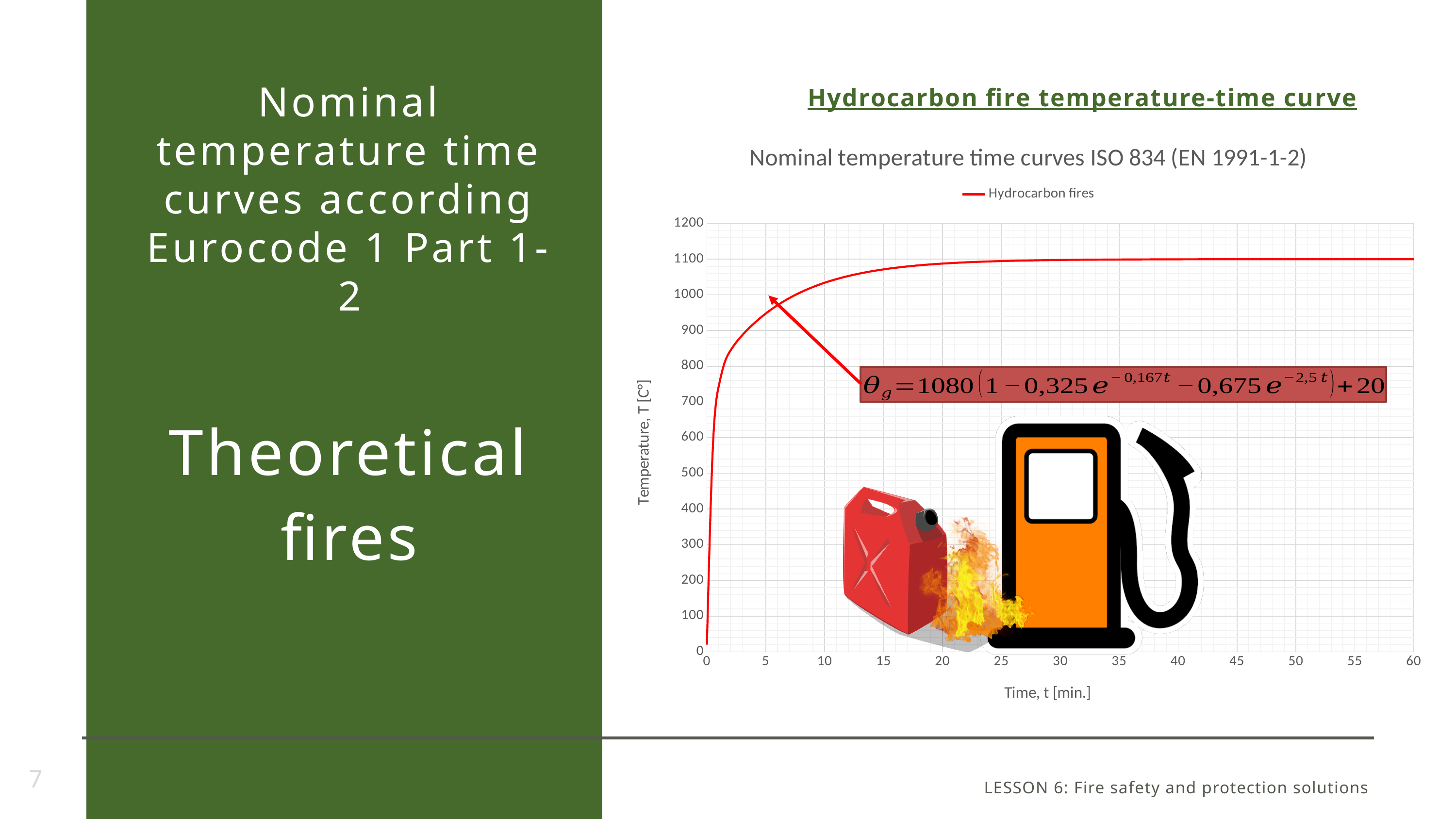
Does the temperature rise or fall as time increases along the x axis? rise Is the temperature at 10 minutes greater or less than 1200? less What kind of chart is shown on the slide? line chart Is the temperature at 60 minutes greater or less than 1000? greater Is the temperature at 30 minutes greater or less than 1000? greater What is the name of the series shown in the chart legend? Hydrocarbon fires How many series does the chart legend list? 1 What is the highest value shown on the y axis of the chart? 1200 What is the title of the chart? Nominal temperature time curves ISO 834 (EN 1991-1-2)